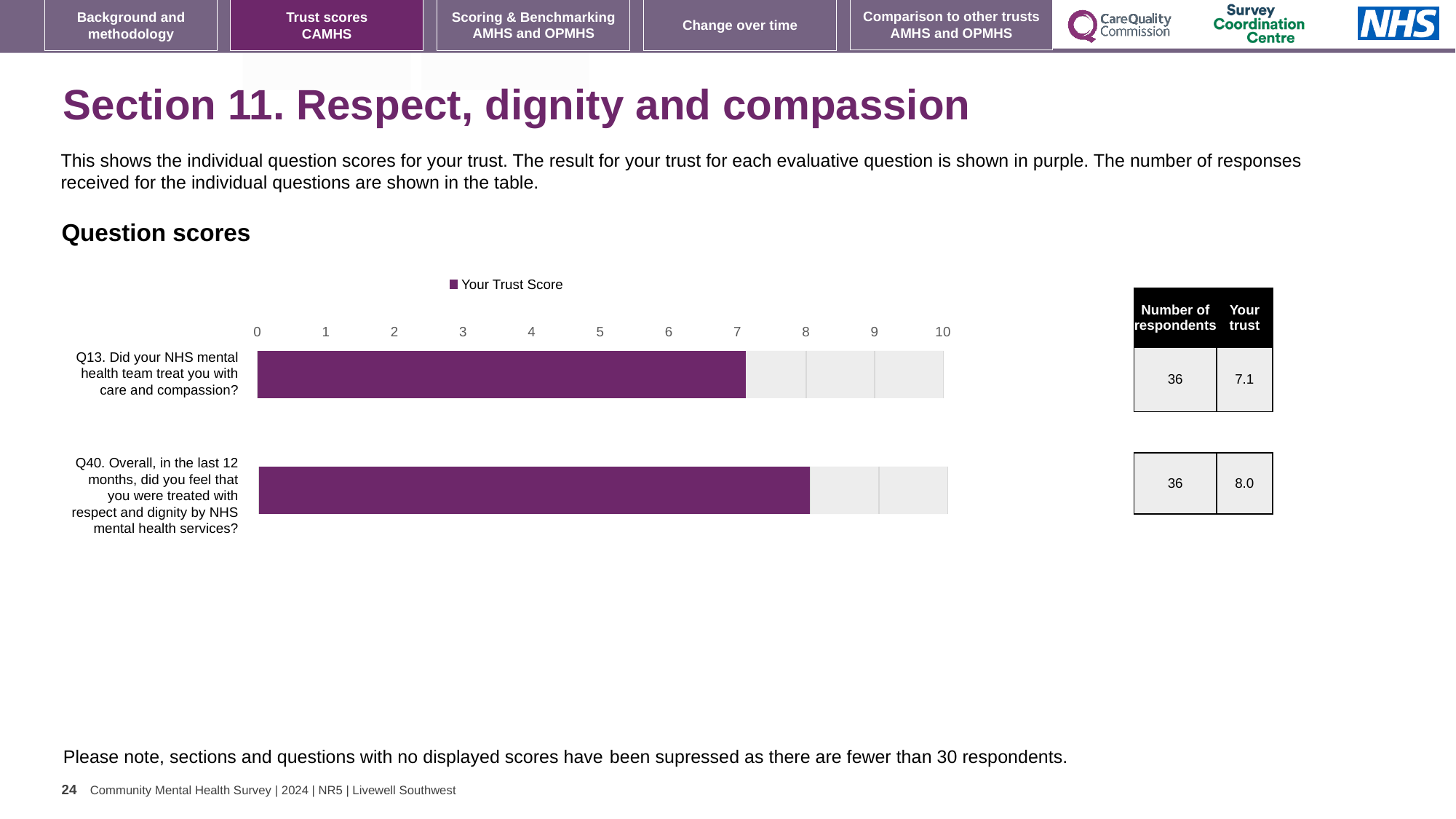
How many questions are plotted on the chart? 2 Which question has the highest trust score on the chart? Q40 What is the difference between the trust scores for Q40 and Q13? 0.9 Which question has the lowest trust score on the chart? Q13 What is the trust score for Q40 (Overall, in the last 12 months, did you feel that you were treated with respect and dignity by NHS mental health services?)? 8.0 What kind of chart is shown on the slide? Bar chart How many series does the chart legend list? 1 What is the name of the series shown in the chart legend? Your Trust Score Is the trust score for Q13 greater or less than 8? less Is the trust score for Q40 greater or less than 7? greater Which has the larger trust score, Q13 or Q40? Q40 What is the trust score for Q13 (Did your NHS mental health team treat you with care and compassion?)? 7.1